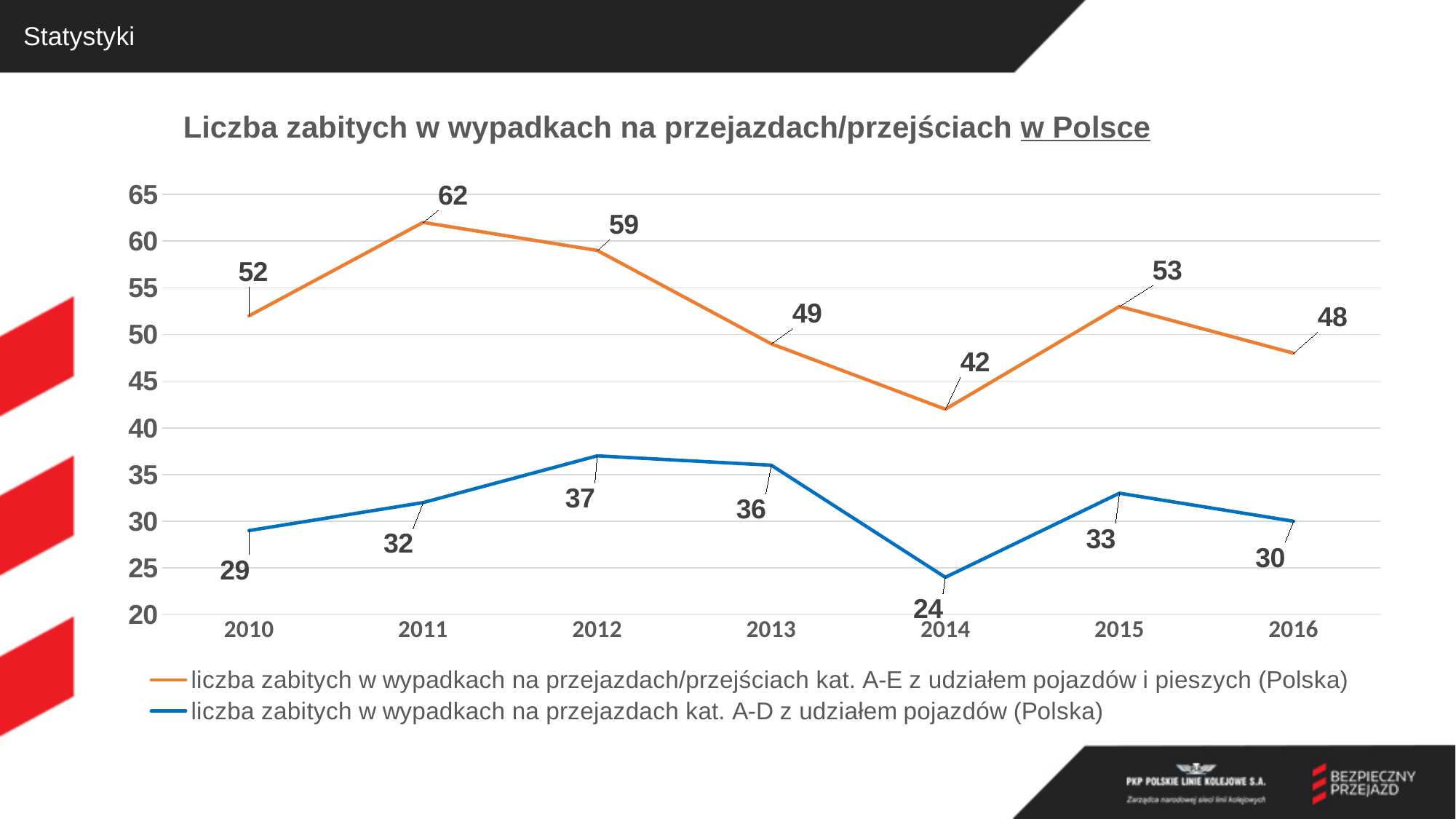
How many years are shown on the x axis? 7 Which year has the larger value for the blue series (kat. A-D): 2012 or 2015? 2012 What is the difference between the orange series (kat. A-E) and the blue series (kat. A-D) in 2010? 23 In which year is the blue series (kat. A-D) at its lowest? 2014 In which year is the orange series (kat. A-E) at its highest? 2011 What kind of chart is shown on the slide? line chart What is the value of the blue series (kat. A-D z udziałem pojazdów) in 2014? 24 Does the orange series (kat. A-E) rise or fall from 2011 to 2014? fall What is the value of the orange series (kat. A-E z udziałem pojazdów i pieszych) in 2011? 62 Is the value of the orange series (kat. A-E) in 2014 greater or less than 45? less What is the value of the orange series (kat. A-E) in 2016? 48 How many series does the legend list? 2